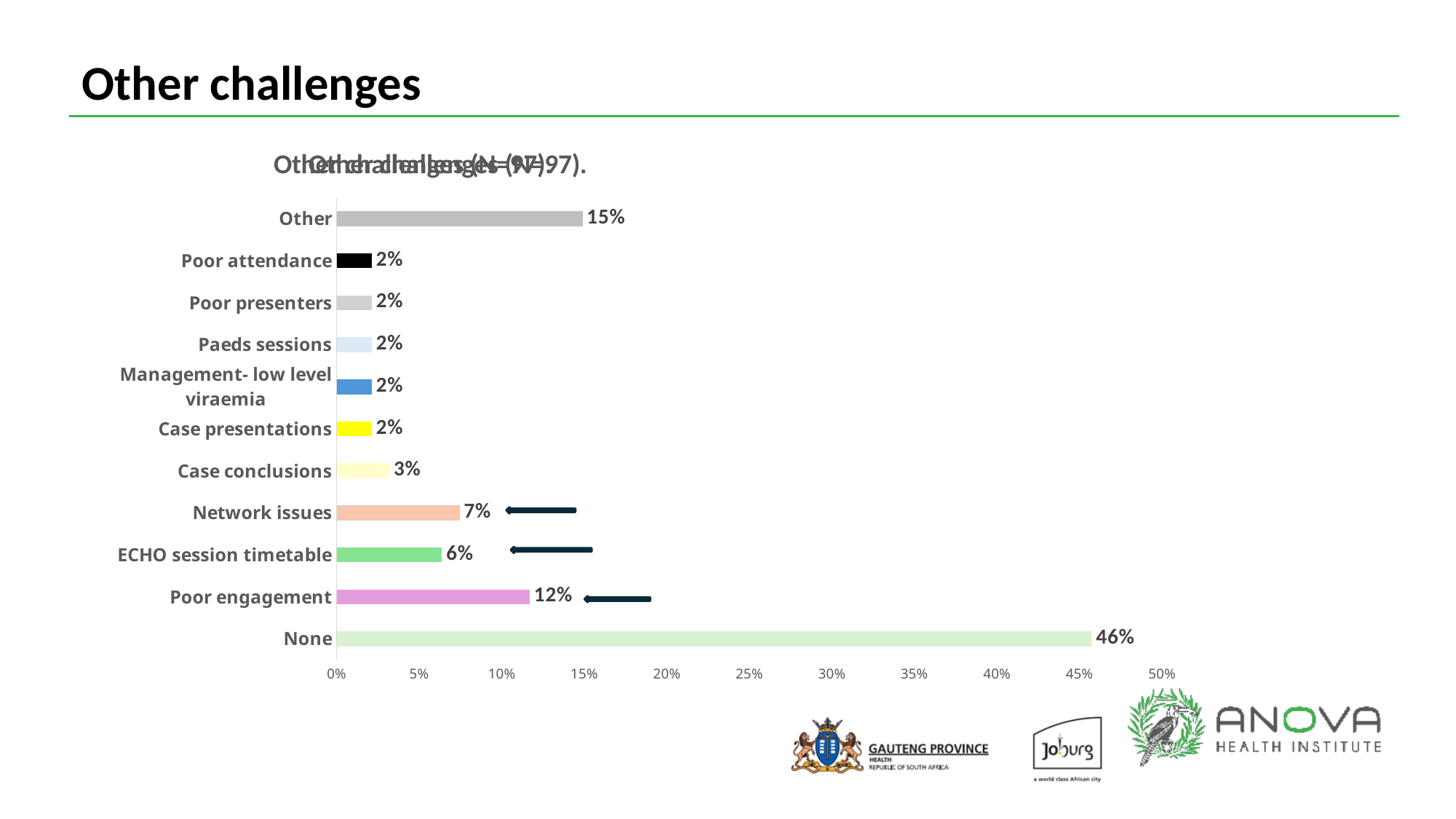
What is the value for Other? 15% Which is larger, the value for Network issues or the value for ECHO session timetable? Network issues What kind of chart is shown on the slide? bar chart What is the value for Case conclusions? 3% Which category has the highest value? None What is the value for None? 46% How many categories are shown in the chart? 11 What is the difference between the values for None and Poor engagement? 34% What is the value for Network issues? 7% Is the value for None greater or less than 40%? greater What is the value for Poor engagement? 12% What is the difference between the values for Other and Poor engagement? 3%